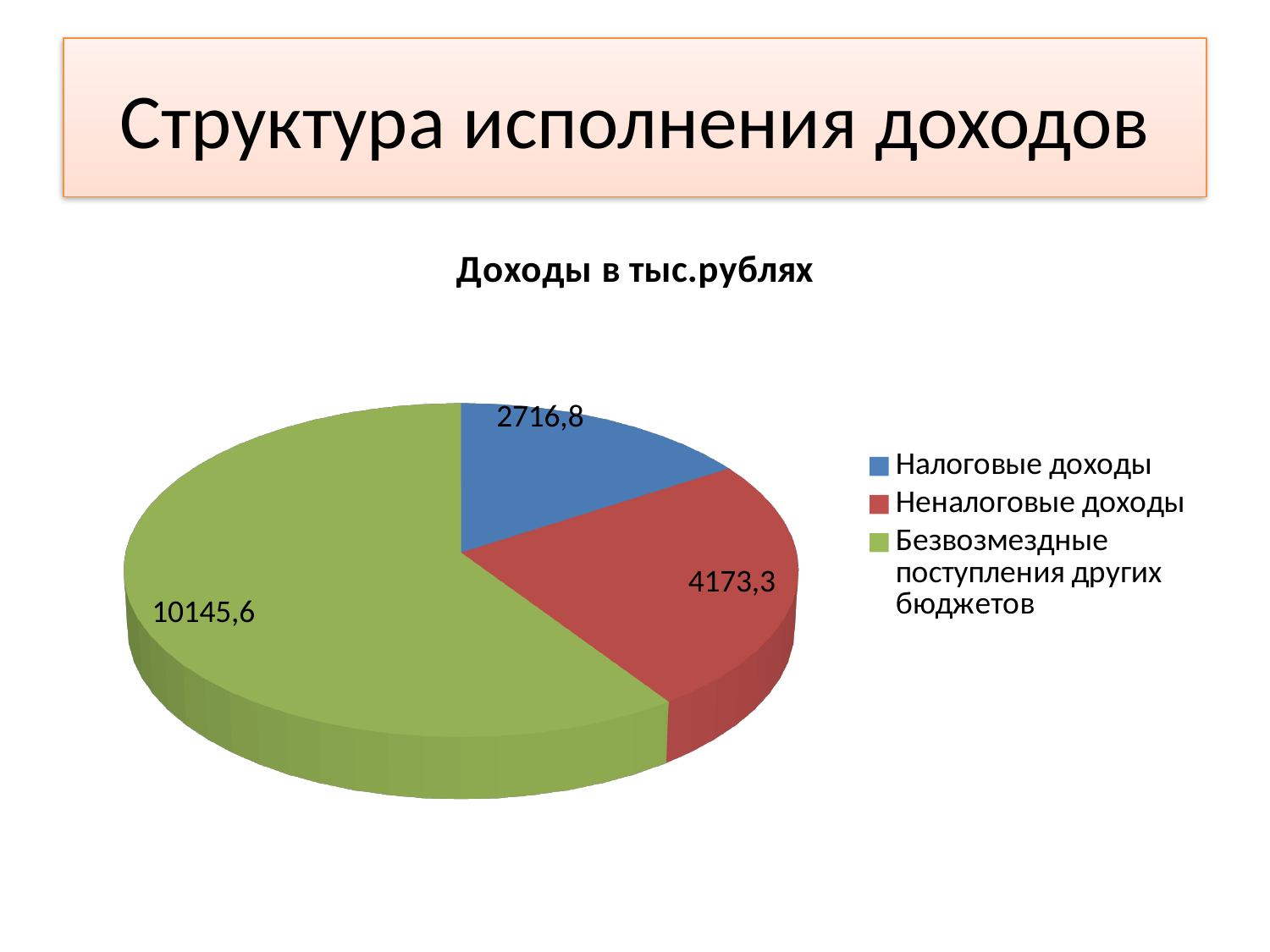
How many slices does the pie chart have? 3 What is the difference between Безвозмездные поступления других бюджетов and Неналоговые доходы? 5972,3 What is the value for Неналоговые доходы? 4173,3 What kind of chart is shown on the slide? Pie chart Which category has the largest slice of the pie? Безвозмездные поступления других бюджетов What is the value for Налоговые доходы? 2716,8 What is the value for Безвозмездные поступления других бюджетов? 10145,6 Which category has the smallest slice of the pie? Налоговые доходы What is the title of the chart? Доходы в тыс.рублях Which is larger, Неналоговые доходы or Налоговые доходы? Неналоговые доходы What colour is the slice for Безвозмездные поступления других бюджетов? Green What is the difference between Неналоговые доходы and Налоговые доходы? 1456,5